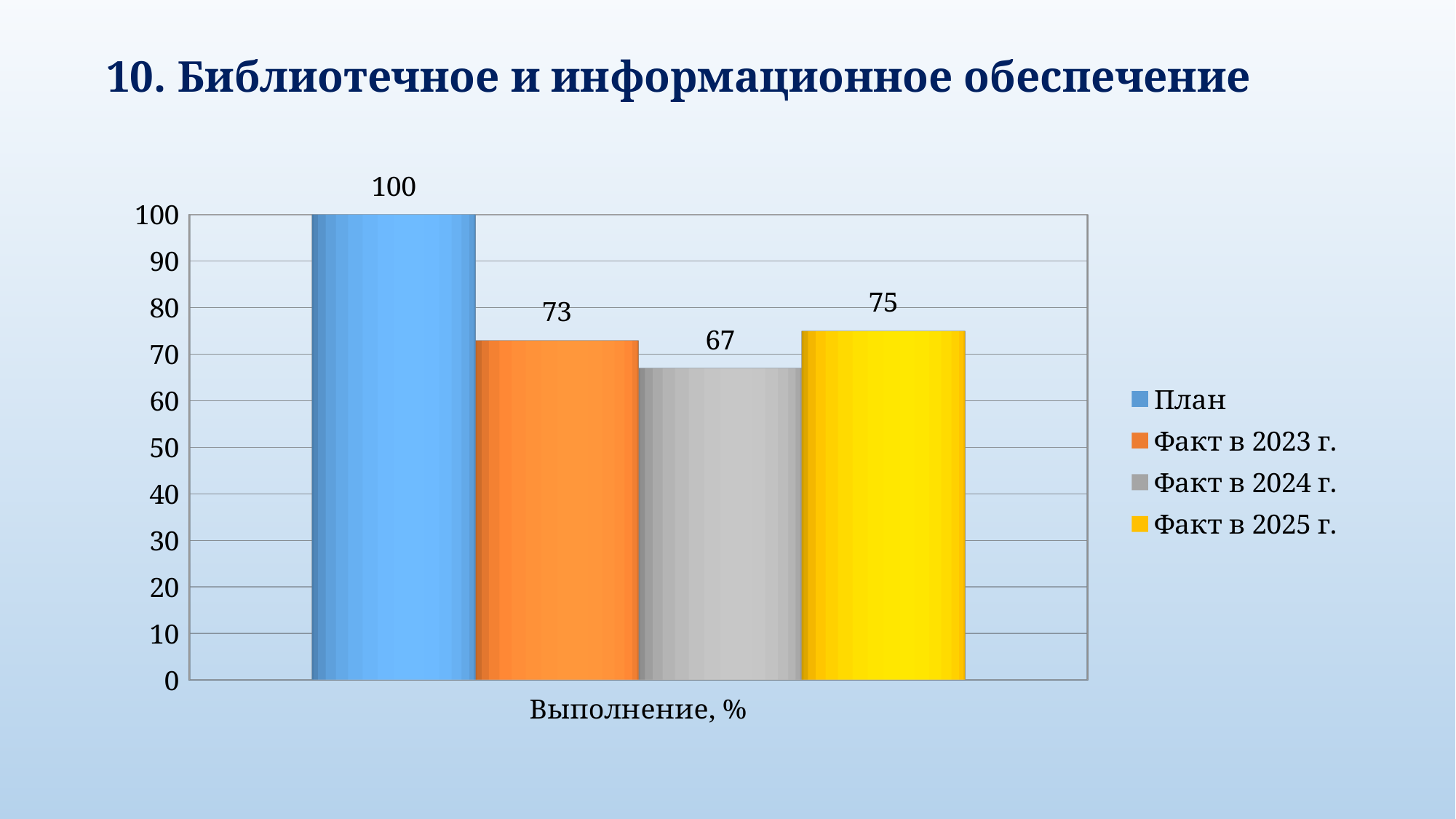
What is the value for Факт в 2023 г.? 73 What is the value for Факт в 2025 г.? 75 Which series has the lowest value? Факт в 2024 г. What is the value for Факт в 2024 г.? 67 What kind of chart is shown on the slide? Bar chart What is the value of the План bar? 100 Which is larger: Факт в 2023 г. or Факт в 2025 г.? Факт в 2025 г. How many series does the legend list? 4 What is the label shown on the horizontal axis of the chart? Выполнение, % Which series has the highest value? План What is the difference between the План value and the Факт в 2025 г. value? 25 What is the difference between Факт в 2023 г. and Факт в 2024 г.? 6